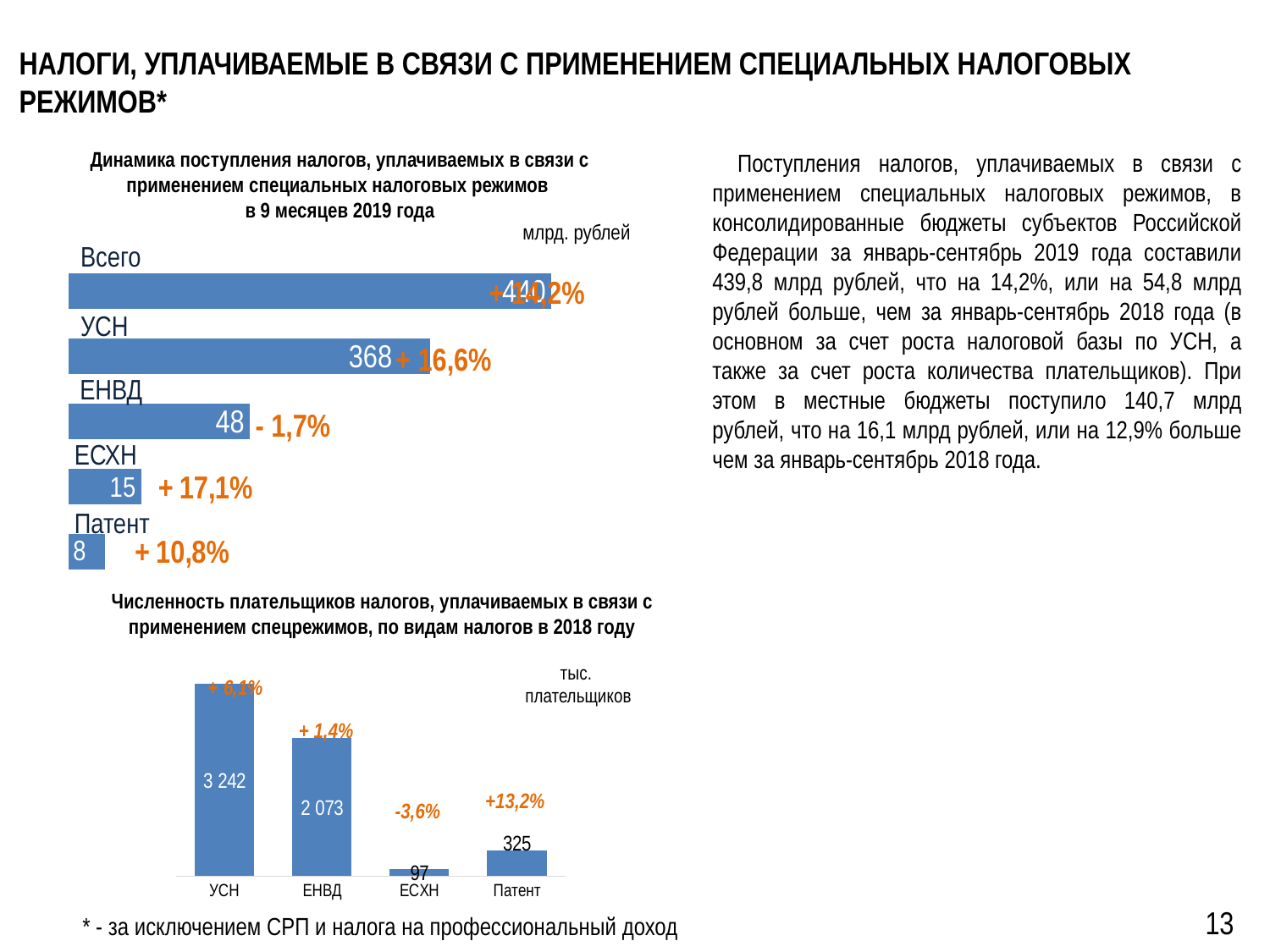
In the bottom chart (Численность плательщиков), which category has the highest value? УСН In the top chart (Динамика поступления налогов), what percentage change is shown next to ЕСХН? + 17,1% In the top chart (Динамика поступления налогов), what is the value for ЕНВД? 48 In the top chart (Динамика поступления налогов), which category other than Всего has the lowest value? Патент What kind of chart is the bottom chart (Численность плательщиков)? bar chart In the top chart (Динамика поступления налогов), what is the value for Патент? 8 In the top chart (Динамика поступления налогов), what is the value for УСН? 368 In the top chart (Динамика поступления налогов), what unit is stated for the values? млрд. рублей In the bottom chart (Численность плательщиков), what is the value for Патент? 325 In the bottom chart (Численность плательщиков), what is the value for ЕНВД? 2 073 In the bottom chart (Численность плательщиков), which category has the lowest value? ЕСХН In the top chart (Динамика поступления налогов), what is the difference between the values for УСН and ЕНВД? 320